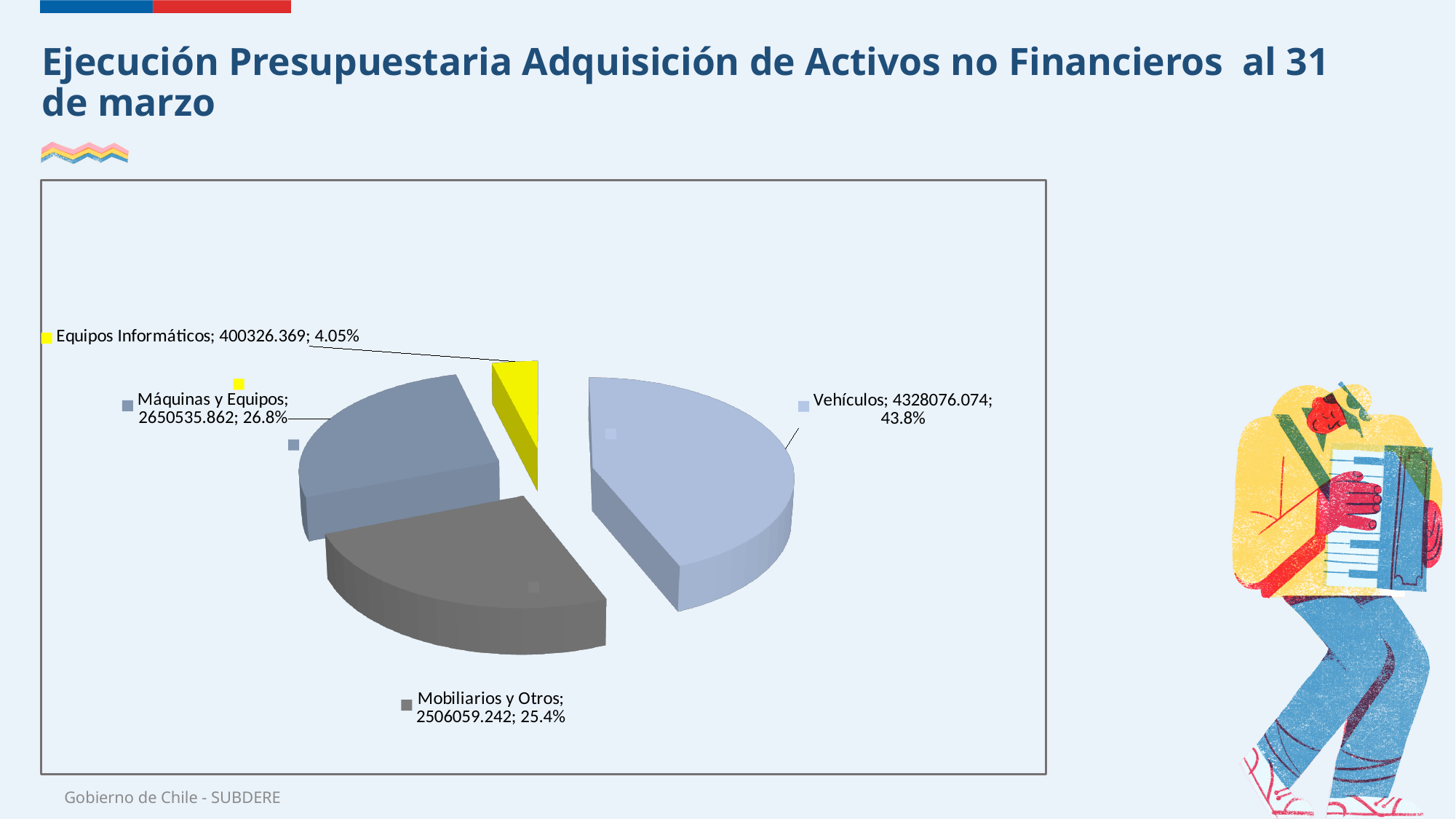
What is the value shown for Mobiliarios y Otros? 2506059.242 What is the value shown for Vehículos? 4328076.074 How many slices does the pie chart have? 4 Which has a larger share, Máquinas y Equipos or Mobiliarios y Otros? Máquinas y Equipos Which category has the smallest share of the pie chart? Equipos Informáticos What is the difference in percentage share between Vehículos and Mobiliarios y Otros? 18.4% What colour is the Equipos Informáticos slice? Yellow What percentage share does Vehículos have in the pie chart? 43.8% What is the value shown for Máquinas y Equipos? 2650535.862 Which category has the largest share of the pie chart? Vehículos What percentage share does Equipos Informáticos have in the pie chart? 4.05% What kind of chart is shown on the slide? Pie chart